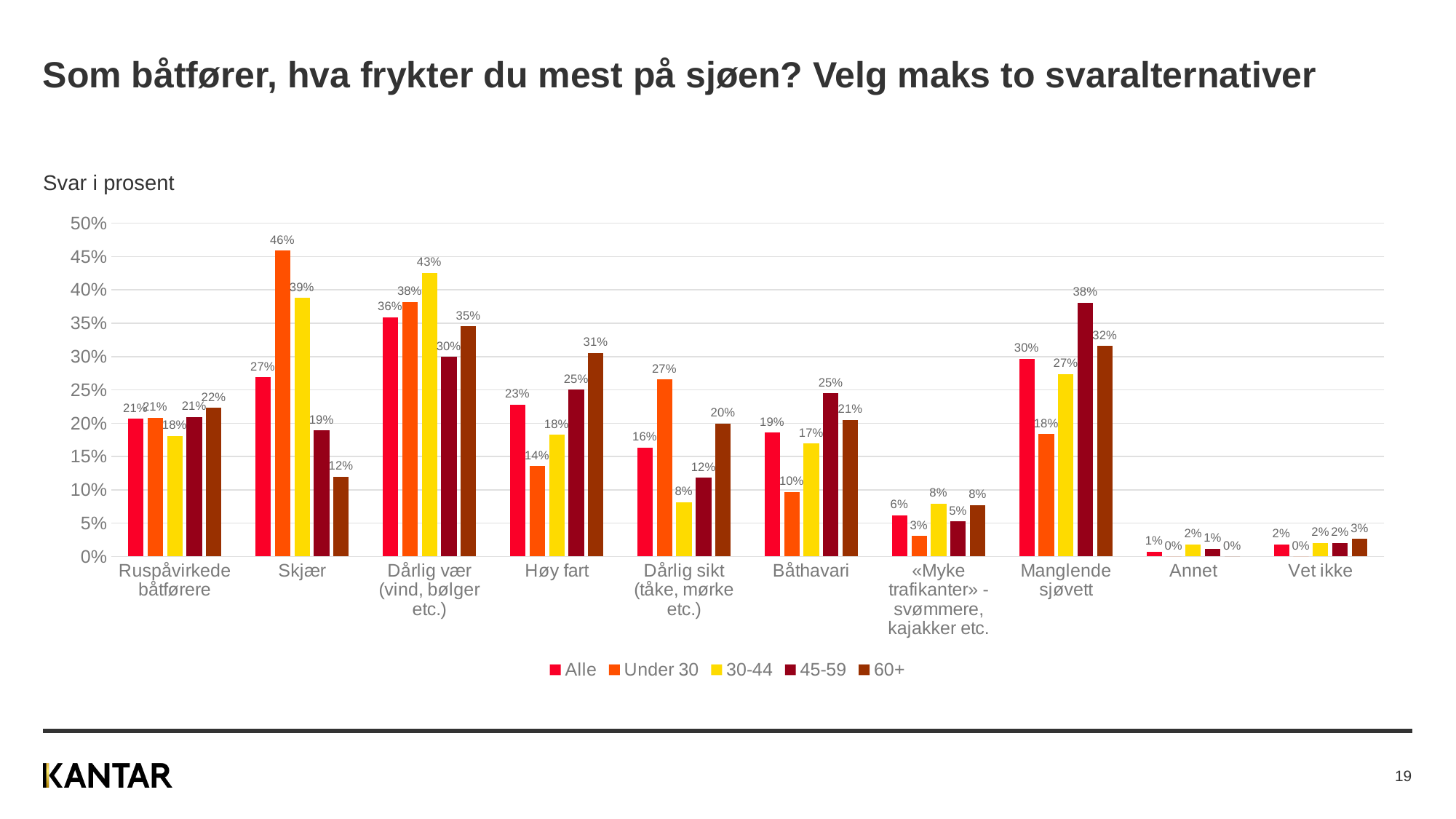
What is the value for Under 30 in the Skjær category? 46% What is the value for 60+ in the Høy fart category? 31% Which category has the highest value for the Alle series? Dårlig vær (vind, bølger etc.) What is the value for 30-44 in the Dårlig vær (vind, bølger etc.) category? 43% In the Manglende sjøvett category, which is larger: the value for 45-59 or the value for Under 30? 45-59 What type of chart is shown on the slide? bar chart What is the subtitle shown above the chart? Svar i prosent Which category has the lowest value for the 60+ series? Annet What is the difference between the Under 30 and 60+ values in the Skjær category? 34% What is the value for 45-59 in the Båthavari category? 25% How many categories are shown on the x axis? 10 How many series does the legend list? 5